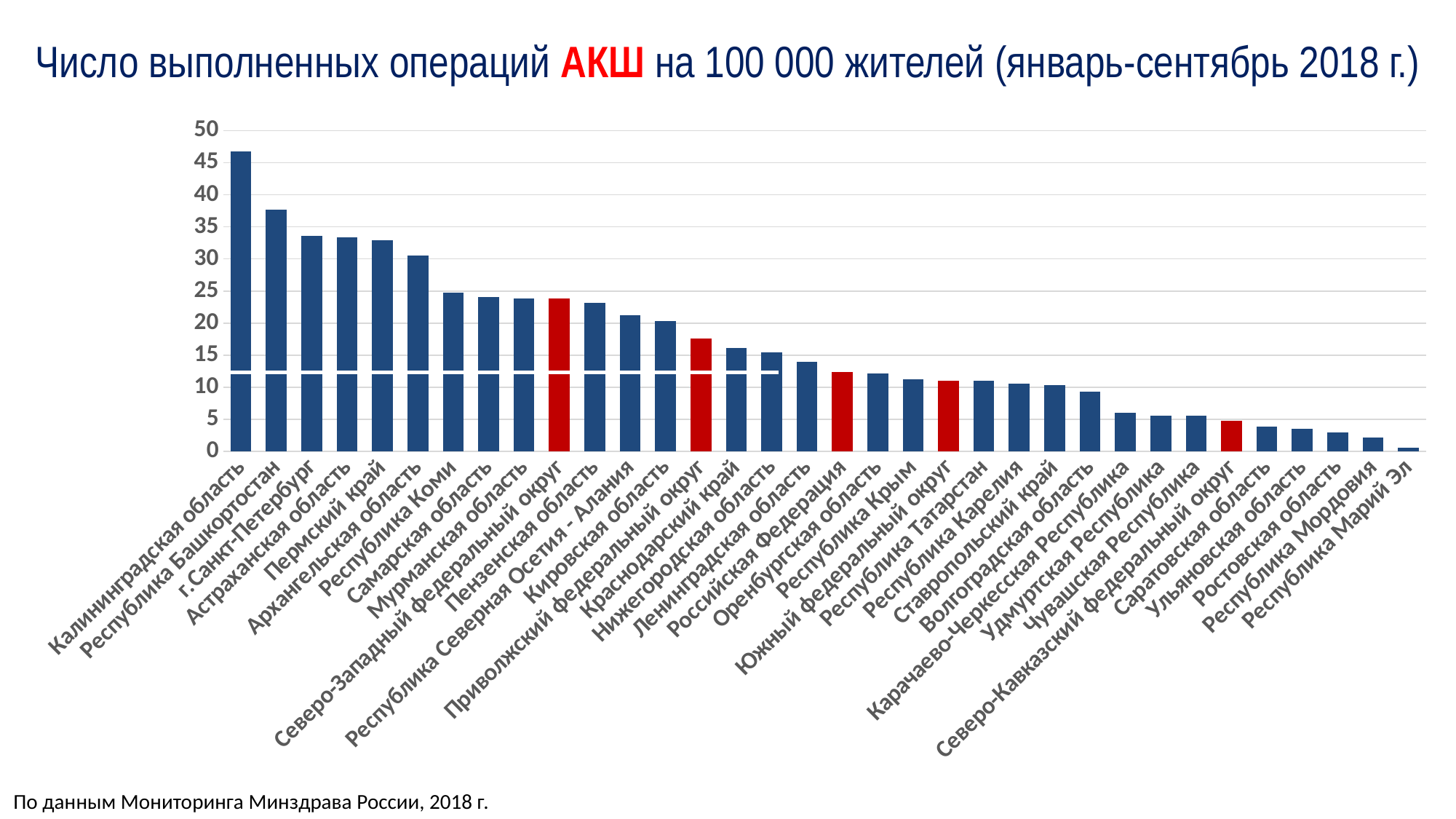
Which has a higher value, Республика Башкортостан or г.Санкт-Петербург? Республика Башкортостан How many bars are highlighted in red? 5 Is the value for г.Санкт-Петербург greater or less than 35? less Which region has the lowest number of АКШ operations per 100 000 residents? Республика Марий Эл Do the values rise or fall moving from left to right along the x axis? fall Which region has the highest number of АКШ operations per 100 000 residents? Калининградская область Is the value for Калининградская область greater or less than 40? greater How many regions (bars) are shown in the chart? 34 Is the value for Республика Башкортостан greater or less than 35? greater What kind of chart is shown on the slide? bar chart